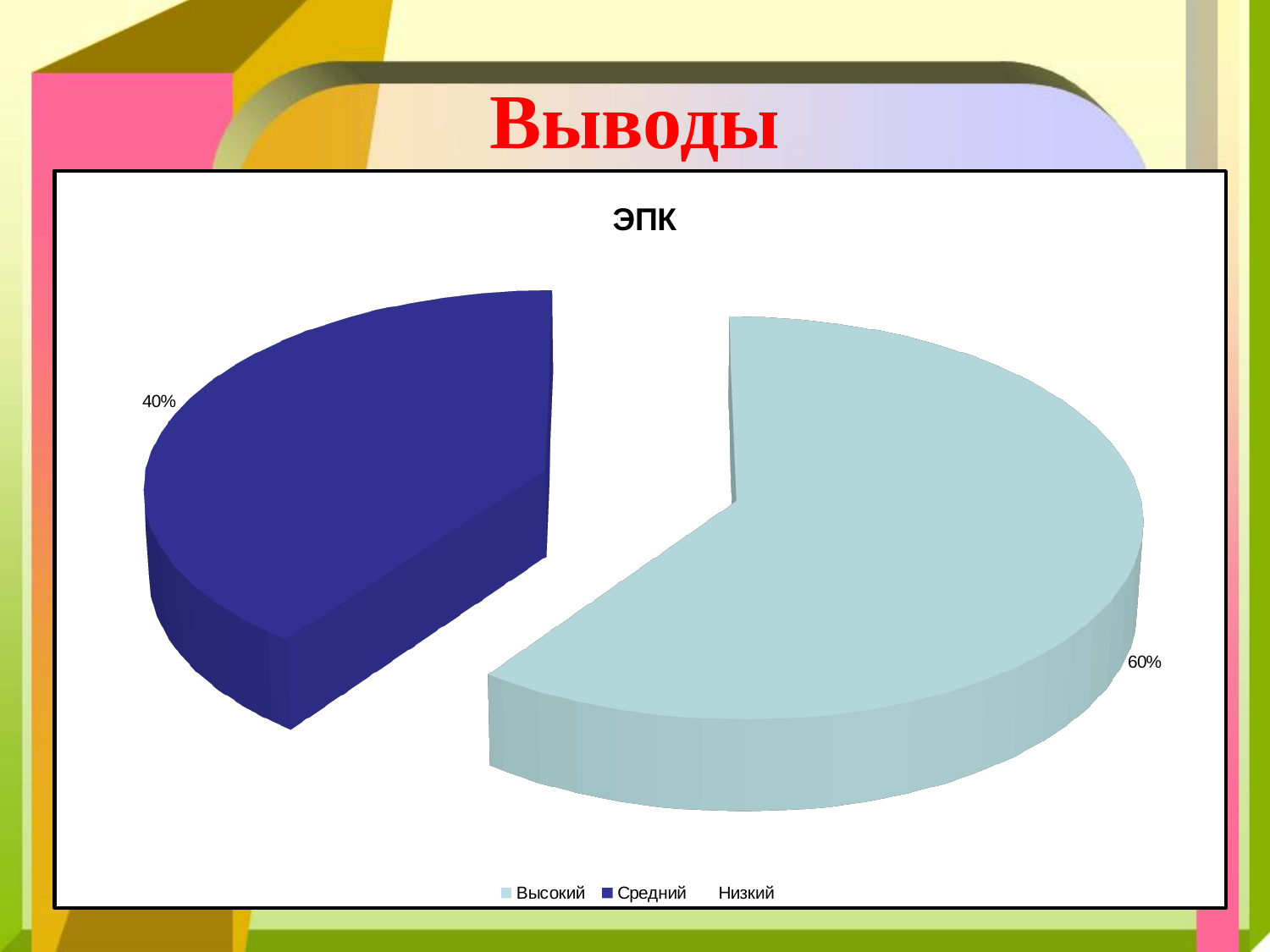
Which of the two labelled slices is larger, Высокий or Средний? Высокий Which legend entry corresponds to the light blue slice? Высокий Is the share for Высокий greater or less than 50%? greater What is the title of the chart? ЭПК What share of the pie does Средний have? 40% How many entries does the legend list? 3 Is the share for Средний greater or less than 50%? less What share of the pie does Высокий have? 60% How many slices are visible in the pie? 2 What is the difference in percentage points between the Высокий and Средний slices? 20% Which category has the largest slice of the pie? Высокий What kind of chart is shown on the slide? pie chart